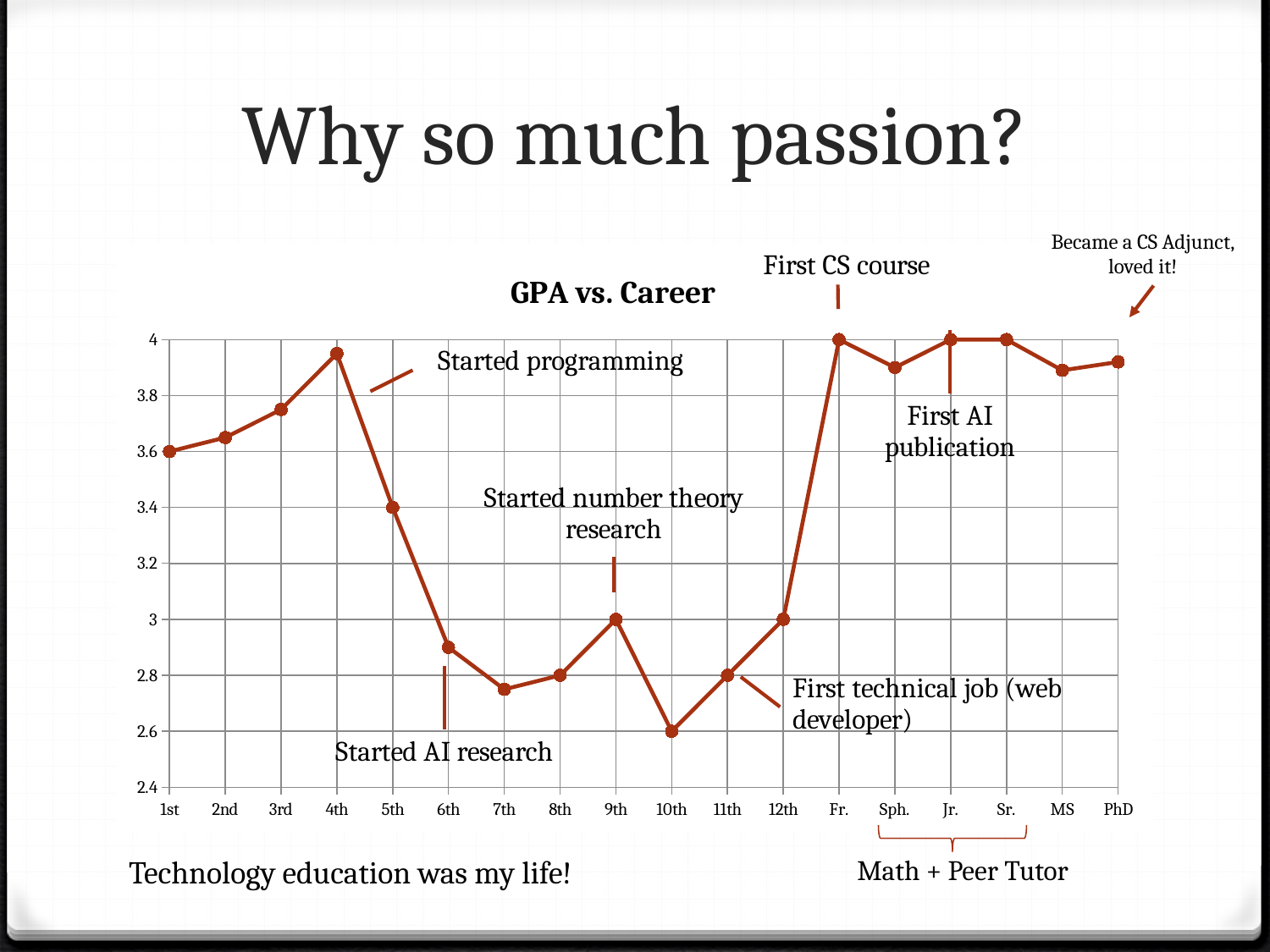
What is the difference between the GPA values for 12th and 10th? 0.4 What is the title of the chart? GPA vs. Career What is the GPA value for 10th? 2.6 How many data points are plotted on the line? 18 What is the GPA value for Fr.? 4 Which category has the lowest GPA value? 10th Which has a larger GPA value, 1st or 5th? 1st What is the GPA value for 1st? 3.6 Which event is annotated at the 6th point on the chart? Started AI research What type of chart is shown on the slide? line chart Is the value for 4th greater or less than 3.8? greater Do the values rise or fall from 1st to 4th? rise